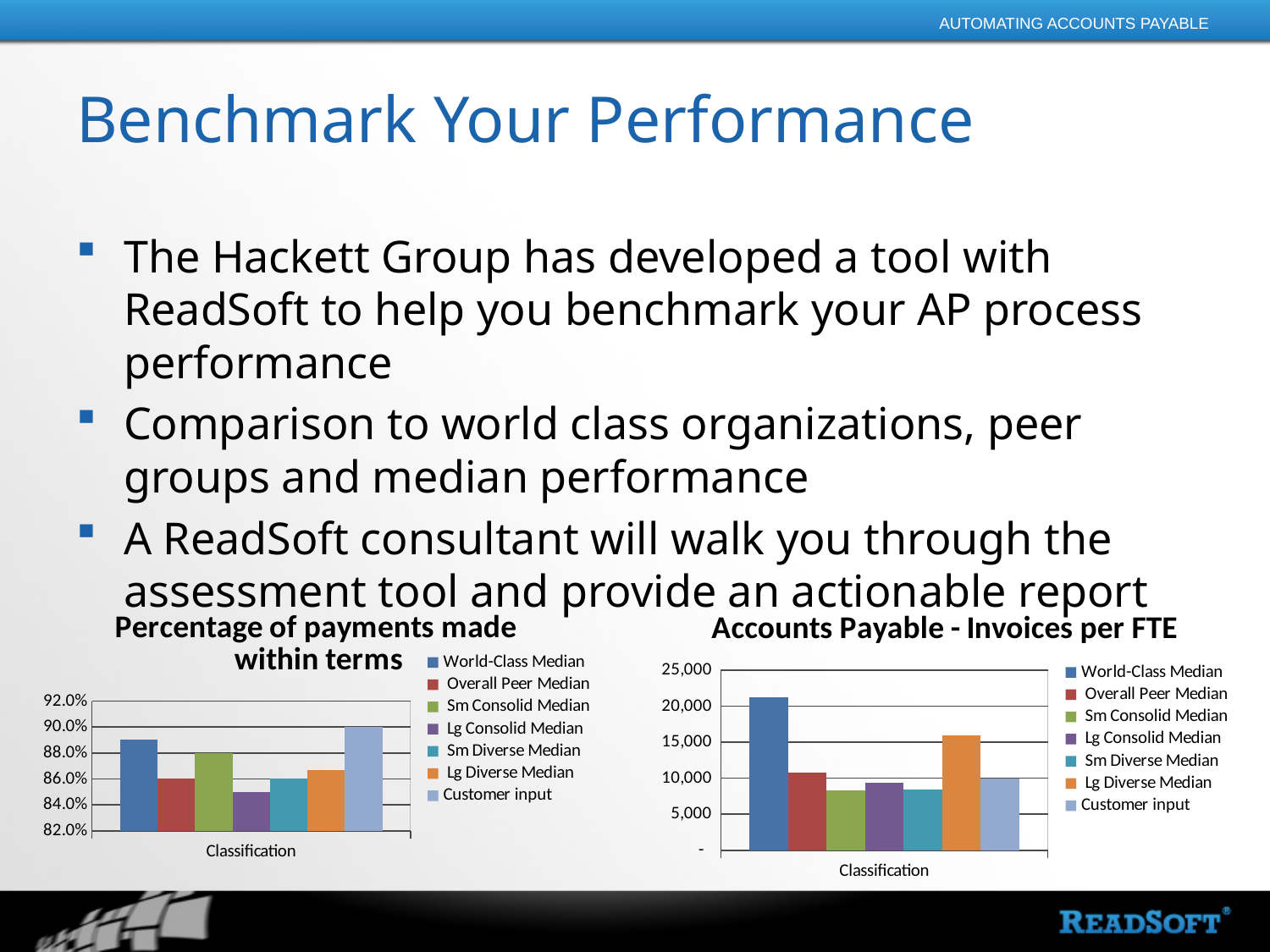
What kind of chart is the 'Percentage of payments made within terms' chart? Bar chart In the 'Accounts Payable - Invoices per FTE' chart, is the value for Sm Consolid Median greater or less than 10,000? less In the 'Percentage of payments made within terms' chart, which is larger: Customer input or Overall Peer Median? Customer input In the 'Accounts Payable - Invoices per FTE' chart, which series has the highest value? World-Class Median In the 'Accounts Payable - Invoices per FTE' chart, is the value for World-Class Median greater or less than 20,000? greater In the 'Accounts Payable - Invoices per FTE' chart, which is larger: Lg Diverse Median or Overall Peer Median? Lg Diverse Median In the 'Percentage of payments made within terms' chart, which series has the lowest value? Lg Consolid Median In the 'Percentage of payments made within terms' chart, is the value for Lg Consolid Median greater or less than 86.0%? less In the 'Percentage of payments made within terms' chart, which series has the highest value? Customer input How many series does the legend of the 'Accounts Payable - Invoices per FTE' chart list? 7